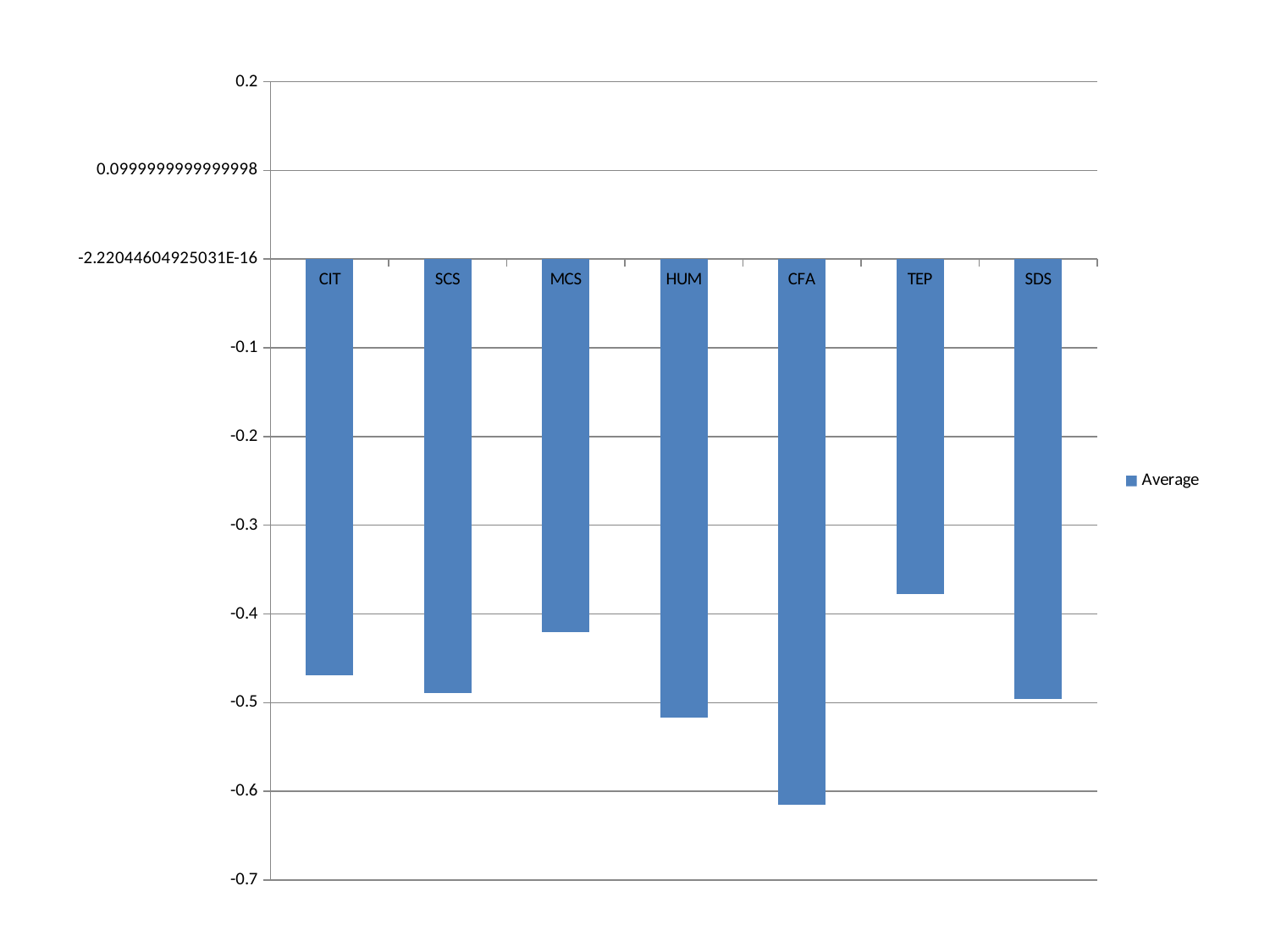
Which category has the highest (least negative) value? TEP Is the value for CFA greater or less than -0.6? less Is the value for TEP greater or less than -0.4? greater Which has the larger value, MCS or TEP? TEP What is the name of the series shown in the legend? Average How many categories are plotted in the chart? 7 Which has the larger value, HUM or CFA? HUM Is the value for MCS greater or less than -0.5? greater What kind of chart is shown on the slide? bar chart Which category has the lowest (most negative) value? CFA How many series does the legend list? 1